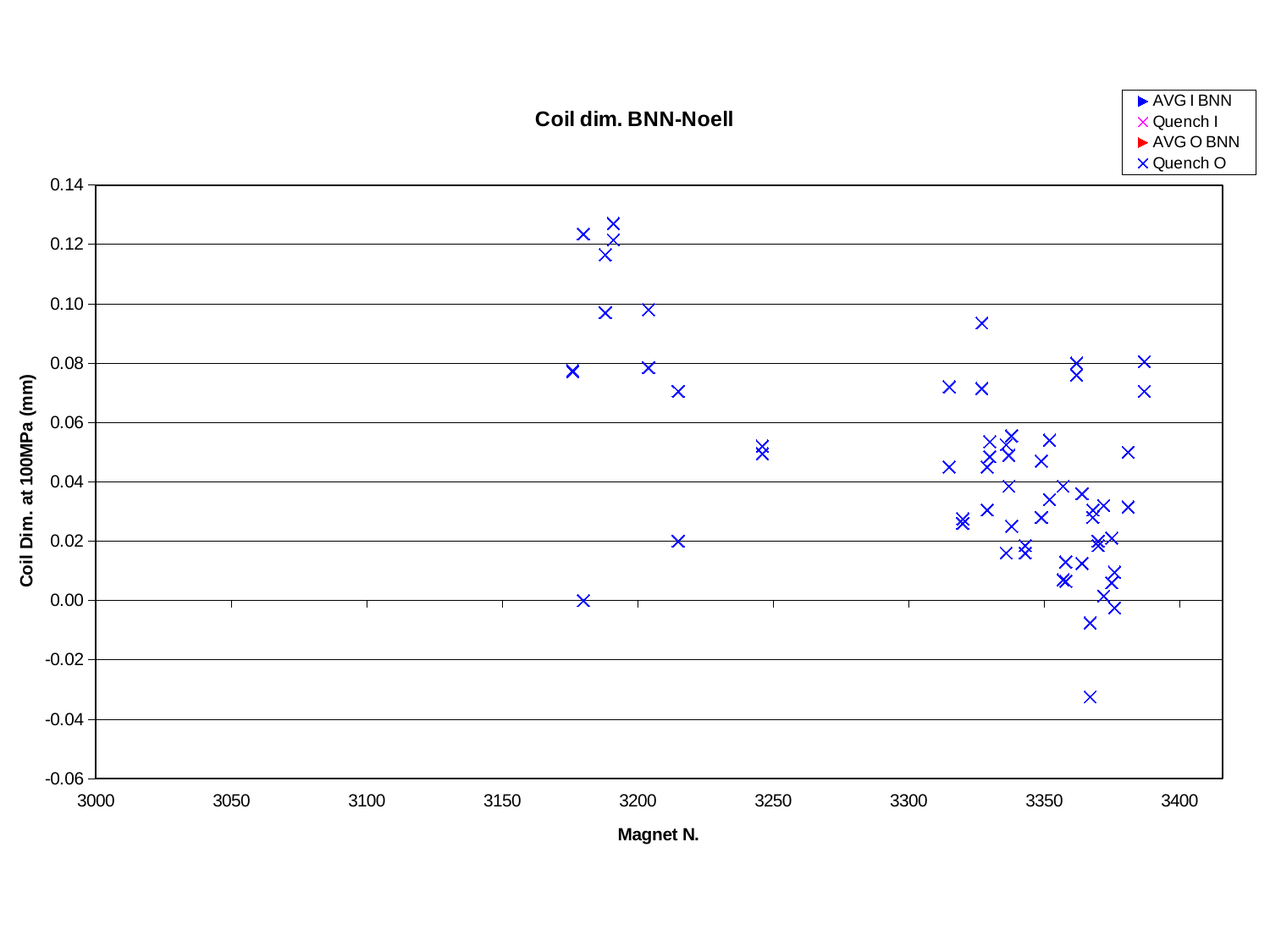
What kind of chart is shown on the slide? Scatter chart Is the highest plotted point greater or less than 0.12? greater Is the highest plotted point between magnet numbers 3300 and 3350 greater or less than 0.08? greater Is the lowest plotted point near magnet number 3180 greater or less than 0.02? less How many series does the legend list? 4 What is the title of the chart? Coil dim. BNN-Noell What is the label of the vertical axis? Coil Dim. at 100MPa (mm)